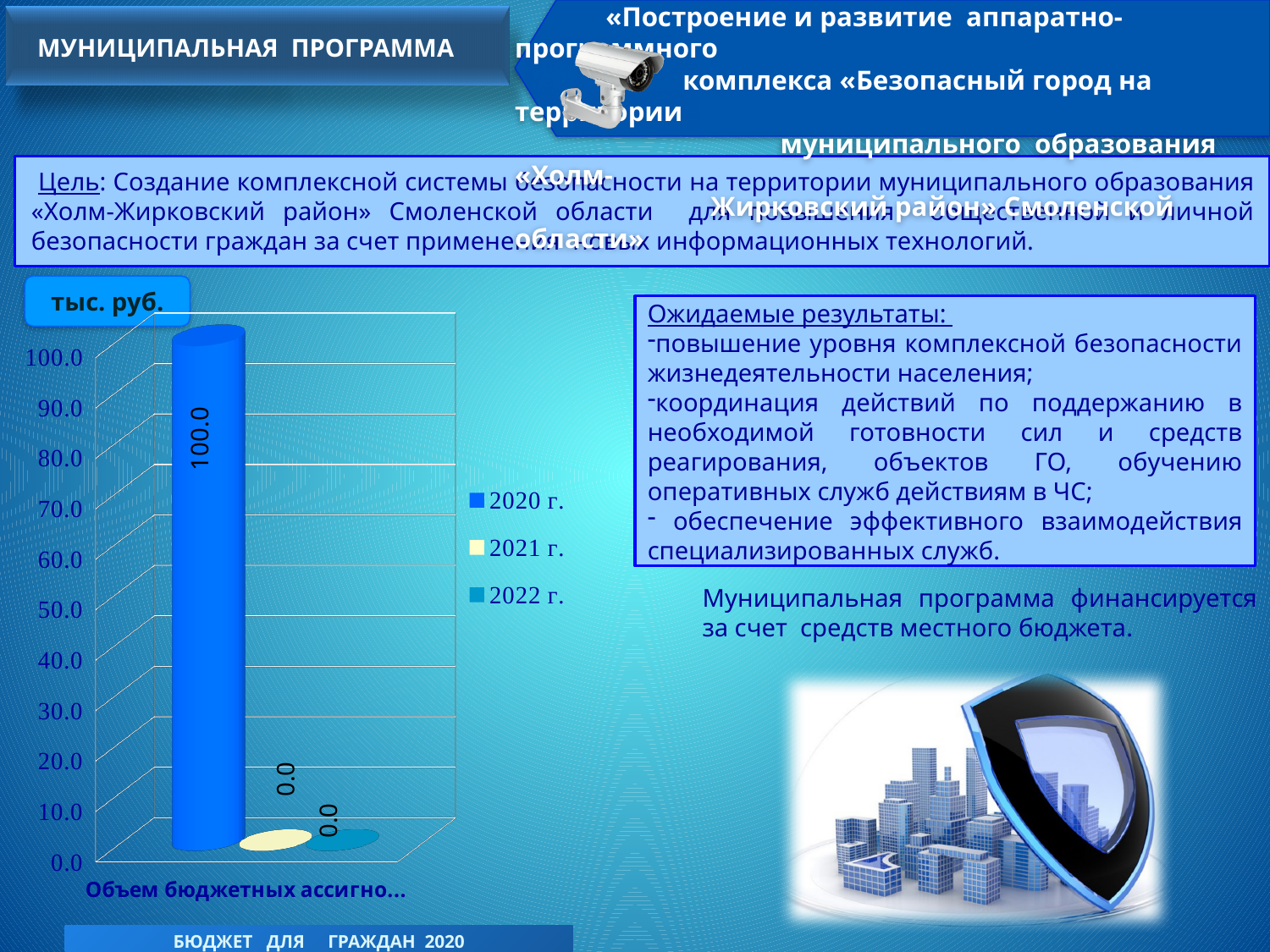
Which is larger, the value for 2020 г. or the value for 2022 г.? 2020 г. How many series does the chart legend list? 3 What is the difference between the values for 2020 г. and 2021 г.? 100.0 Is the value for 2020 г. greater or less than 50.0? greater What is the value for the 2020 г. series in the chart? 100.0 What kind of chart is shown on the slide? bar chart Which series has the highest value in the chart? 2020 г. What is the total of the values for 2020 г., 2021 г. and 2022 г.? 100.0 What is the highest value shown on the chart's vertical axis? 100.0 What is the value for the 2021 г. series in the chart? 0.0 What unit is indicated above the chart? тыс. руб. What is the value for the 2022 г. series in the chart? 0.0